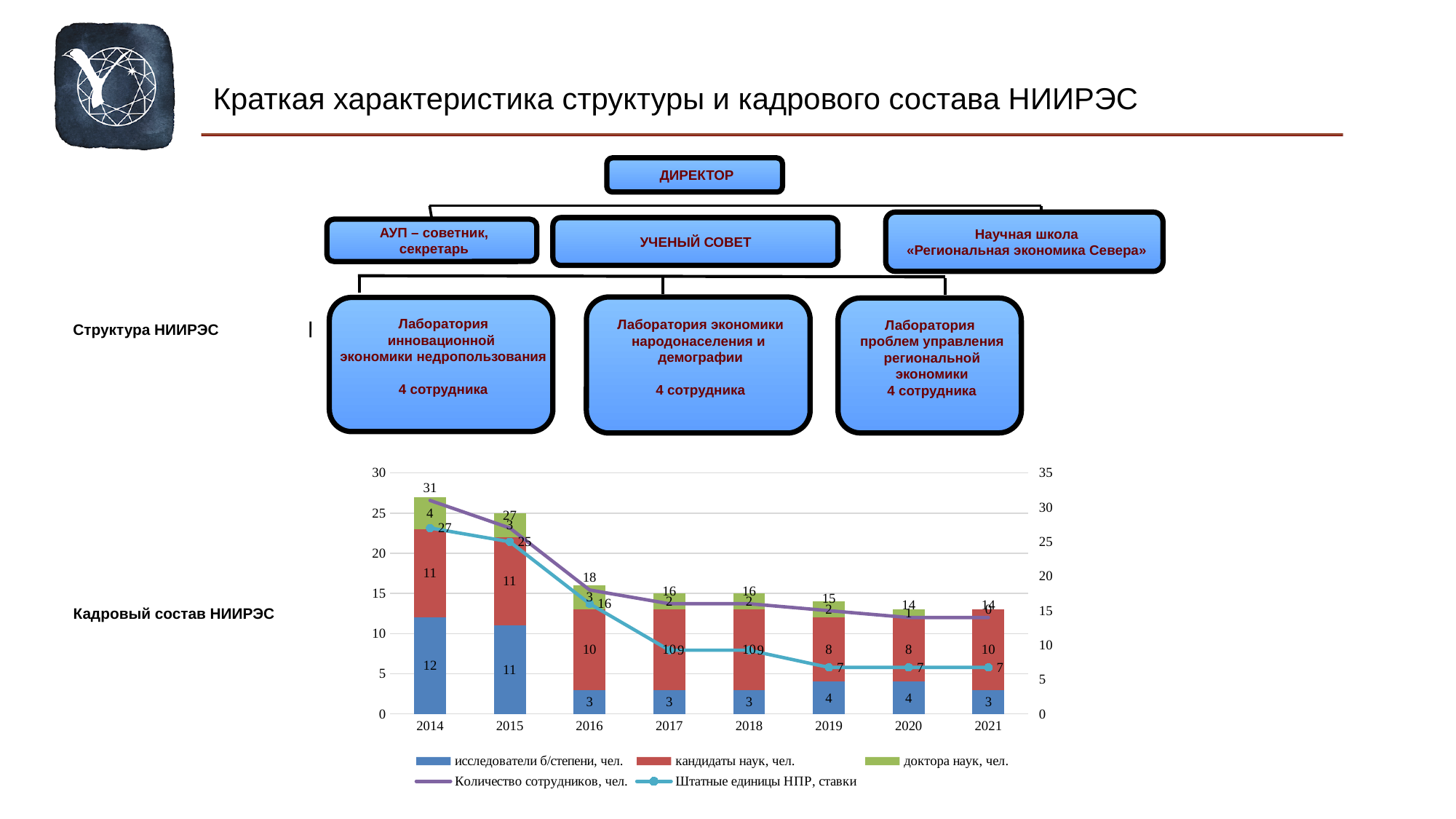
What is the value for Количество сотрудников, чел. in 2014? 31 What is the difference between Количество сотрудников, чел. in 2014 and in 2015? 4 Which year has the larger value for кандидаты наук, чел.: 2014 or 2019? 2014 Does Количество сотрудников, чел. rise or fall from 2014 to 2021? fall What is the value for доктора наук, чел. in 2014? 4 In which year is Количество сотрудников, чел. highest? 2014 What is the value for кандидаты наук, чел. in 2016? 10 What is the total of the stacked bar for 2014 (исследователи б/степени, кандидаты наук and доктора наук)? 27 How many years are shown on the x axis of the chart? 8 What is the value for Штатные единицы НПР, ставки in 2019? 7 How many series does the chart legend list? 5 What is the value for исследователи б/степени, чел. in 2014? 12